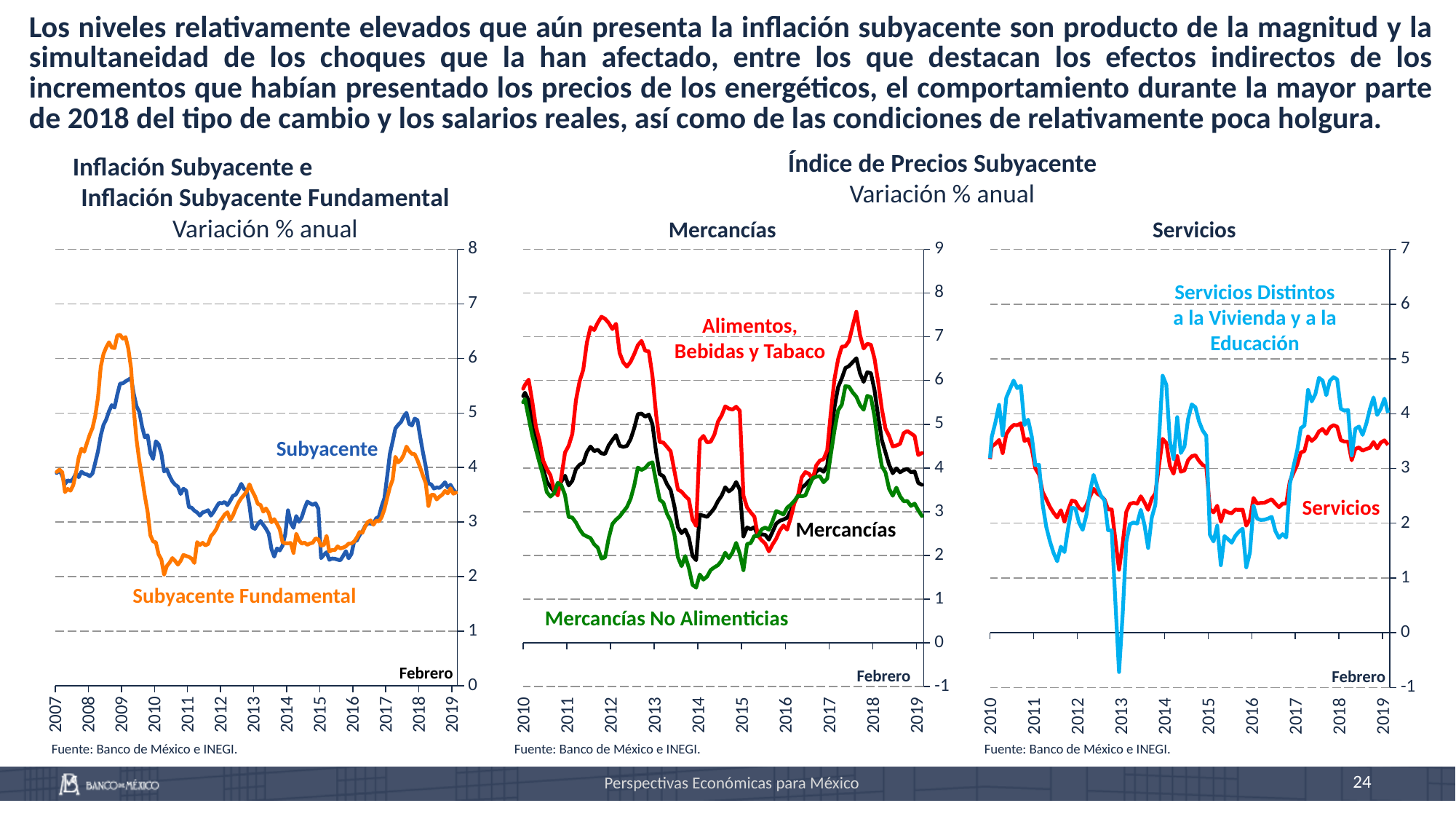
How many series are plotted in the left chart 'Inflación Subyacente e Inflación Subyacente Fundamental'? 2 What kind of chart is the left chart titled 'Inflación Subyacente e Inflación Subyacente Fundamental'? Line chart In the middle chart 'Mercancías', is the lowest value of 'Mercancías No Alimenticias' around 2014 greater or less than 2? less In the left chart, does the 'Subyacente' series rise or fall from its 2017 peak to 2019? Fall How many series are plotted in the right chart 'Servicios'? 2 What is the name of the series plotted in green in the middle chart 'Mercancías'? Mercancías No Alimenticias In the left chart, is the peak value of 'Subyacente Fundamental' around 2009 greater or less than 6? greater In the right chart 'Servicios', is the peak value of 'Servicios Distintos a la Vivienda y a la Educación' around 2018 greater or less than 4? greater How many series are plotted in the middle chart 'Mercancías'? 3 What is the title of the right chart? Servicios